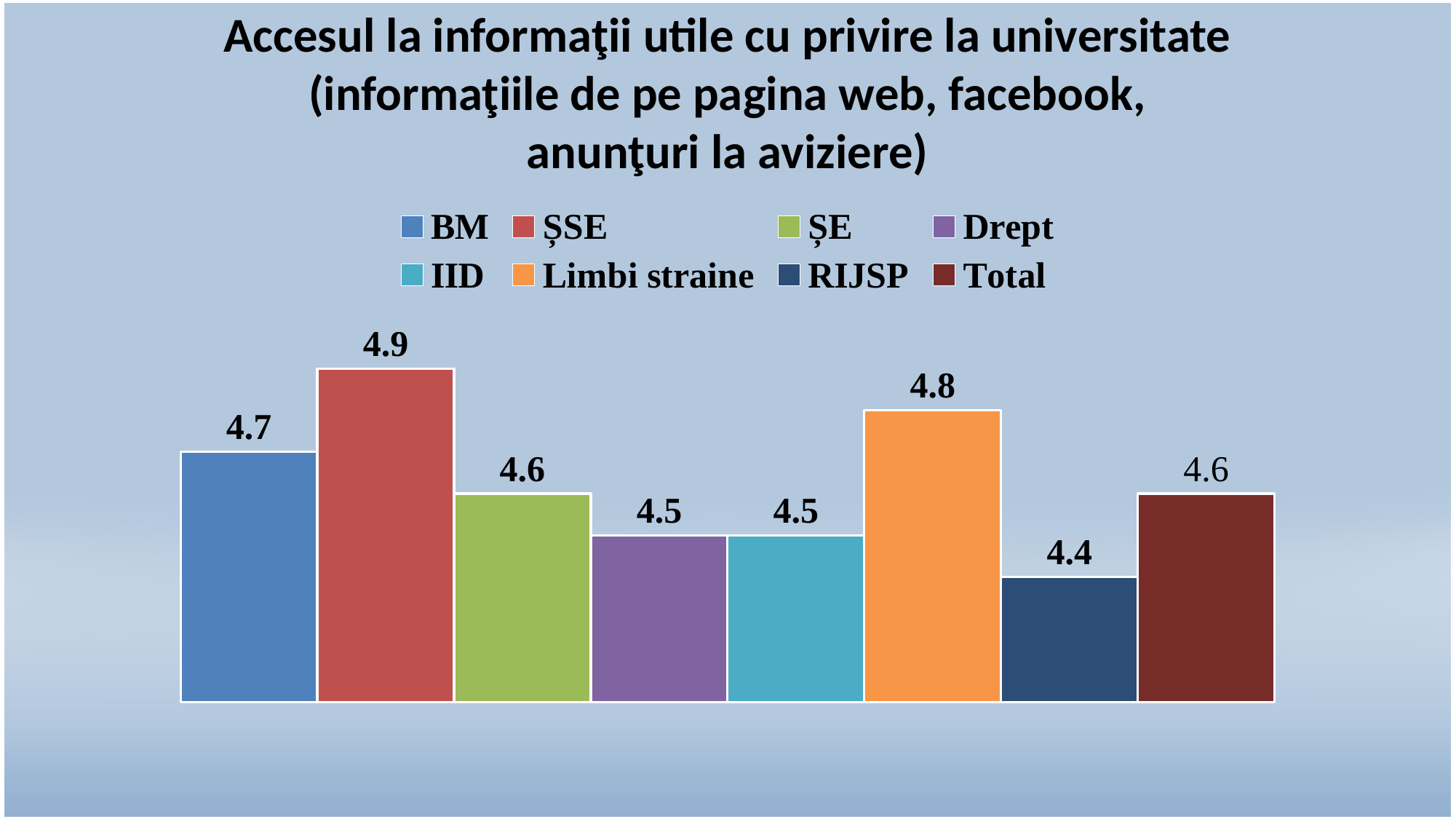
What is the value for Total? 4.6 Which series has the lowest value? RIJSP What kind of chart is shown on the slide? Bar chart Which series has the highest value? ȘSE What is the difference between the values for ȘSE and RIJSP? 0.5 What is the value for RIJSP? 4.4 What colour is the bar for Limbi straine? Orange How many series does the legend list? 8 What is the value for ȘSE? 4.9 What is the value for Limbi straine? 4.8 What is the value for BM? 4.7 Which is larger, the value for BM or the value for ȘE? BM